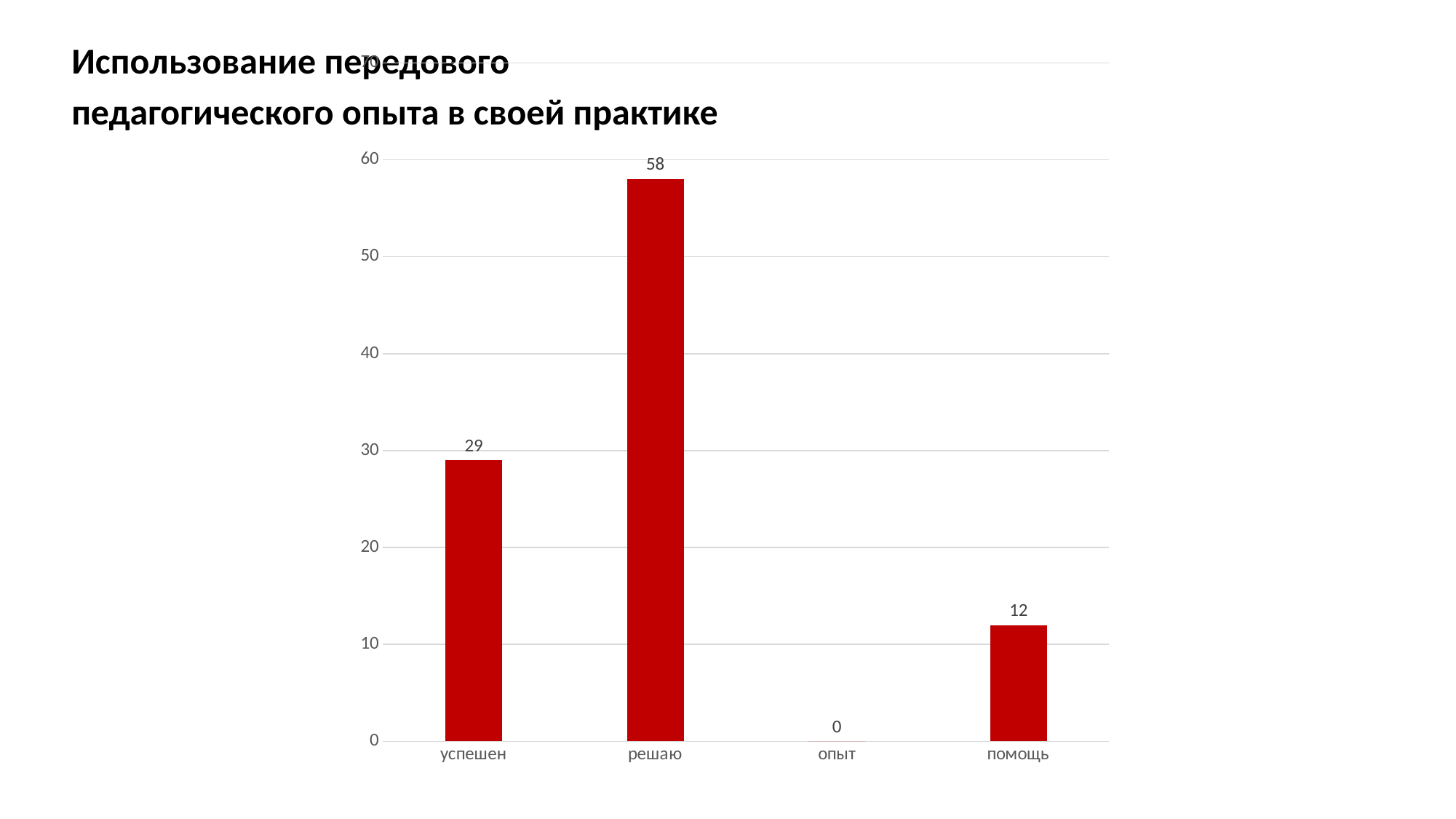
What is the value for опыт? 0 What is the value for решаю? 58 How many categories are shown on the x axis? 4 Which category has the lowest value? опыт What kind of chart is shown on the slide? bar chart Is the value for решаю greater or less than 50? greater What is the difference between the values for успешен and помощь? 17 Which is larger, the value for успешен or the value for помощь? успешен What is the difference between the values for решаю and успешен? 29 Which category has the highest value? решаю What is the value for помощь? 12 What is the value for успешен? 29